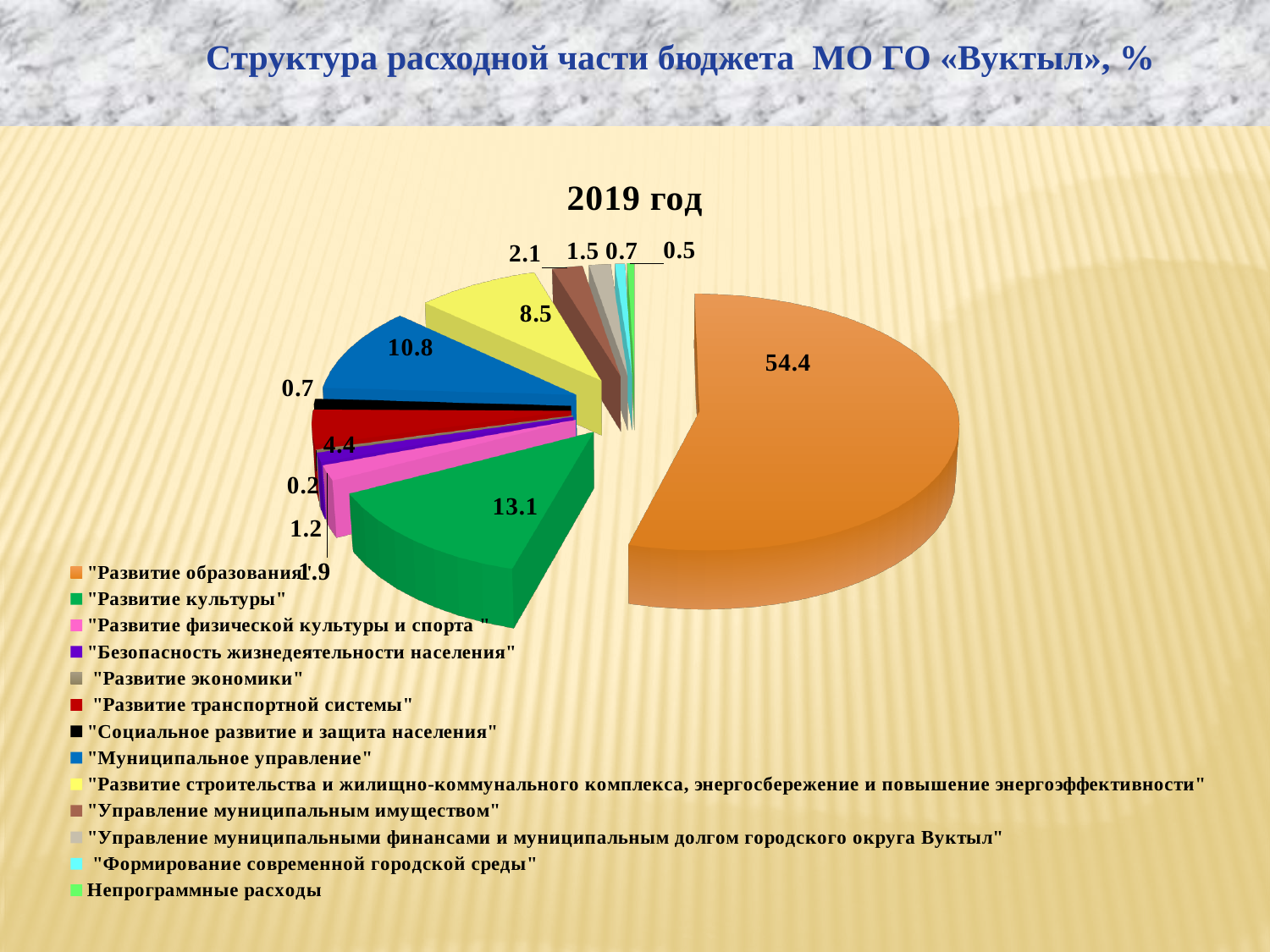
What is the value for "Муниципальное управление"? 10.8 What share of the budget expenditure goes to "Развитие образования"? 54.4 What is the value for "Развитие культуры"? 13.1 What is the value for "Управление муниципальным имуществом"? 2.1 Which is larger: "Муниципальное управление" or "Развитие строительства и жилищно-коммунального комплекса, энергосбережение и повышение энергоэффективности"? "Муниципальное управление" What is the value for "Развитие строительства и жилищно-коммунального комплекса, энергосбережение и повышение энергоэффективности"? 8.5 What is the value for "Развитие транспортной системы"? 4.4 What type of chart is shown on the slide? pie chart What is the title of the chart? 2019 год What is the difference between the values for "Развитие образования" and "Развитие культуры"? 41.3 How many categories does the legend list? 13 Which category has the largest share of the pie? "Развитие образования"